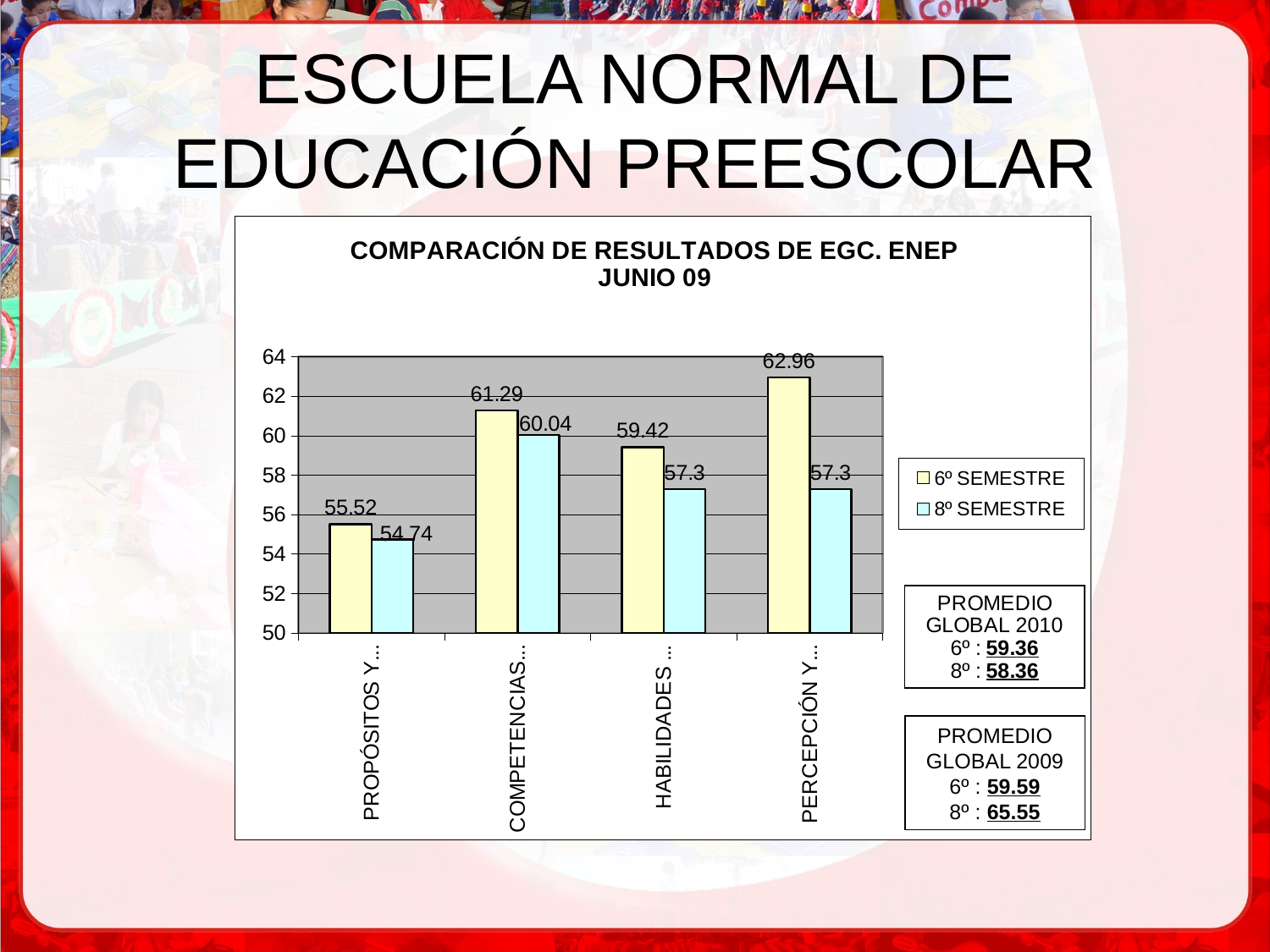
What is the title of the chart? COMPARACIÓN DE RESULTADOS DE EGC. ENEP JUNIO 09 Which category has the highest 6º SEMESTRE value? PERCEPCIÓN Y... What is the 8º SEMESTRE value for the category beginning 'COMPETENCIAS'? 60.04 How many series does the legend list? 2 What type of chart is shown on the slide? bar chart How many categories are shown on the x axis? 4 What is the 6º SEMESTRE value for the category beginning 'PERCEPCIÓN Y'? 62.96 What is the difference between the 6º SEMESTRE and 8º SEMESTRE values for the category beginning 'PERCEPCIÓN Y'? 5.66 Which category has the lowest 8º SEMESTRE value? PROPÓSITOS Y... For the category beginning 'HABILIDADES', which series has the larger value, 6º SEMESTRE or 8º SEMESTRE? 6º SEMESTRE What is the 6º SEMESTRE value for the category beginning 'PROPÓSITOS Y'? 55.52 Is the 8º SEMESTRE value for the category beginning 'PROPÓSITOS Y' greater or less than 56? less